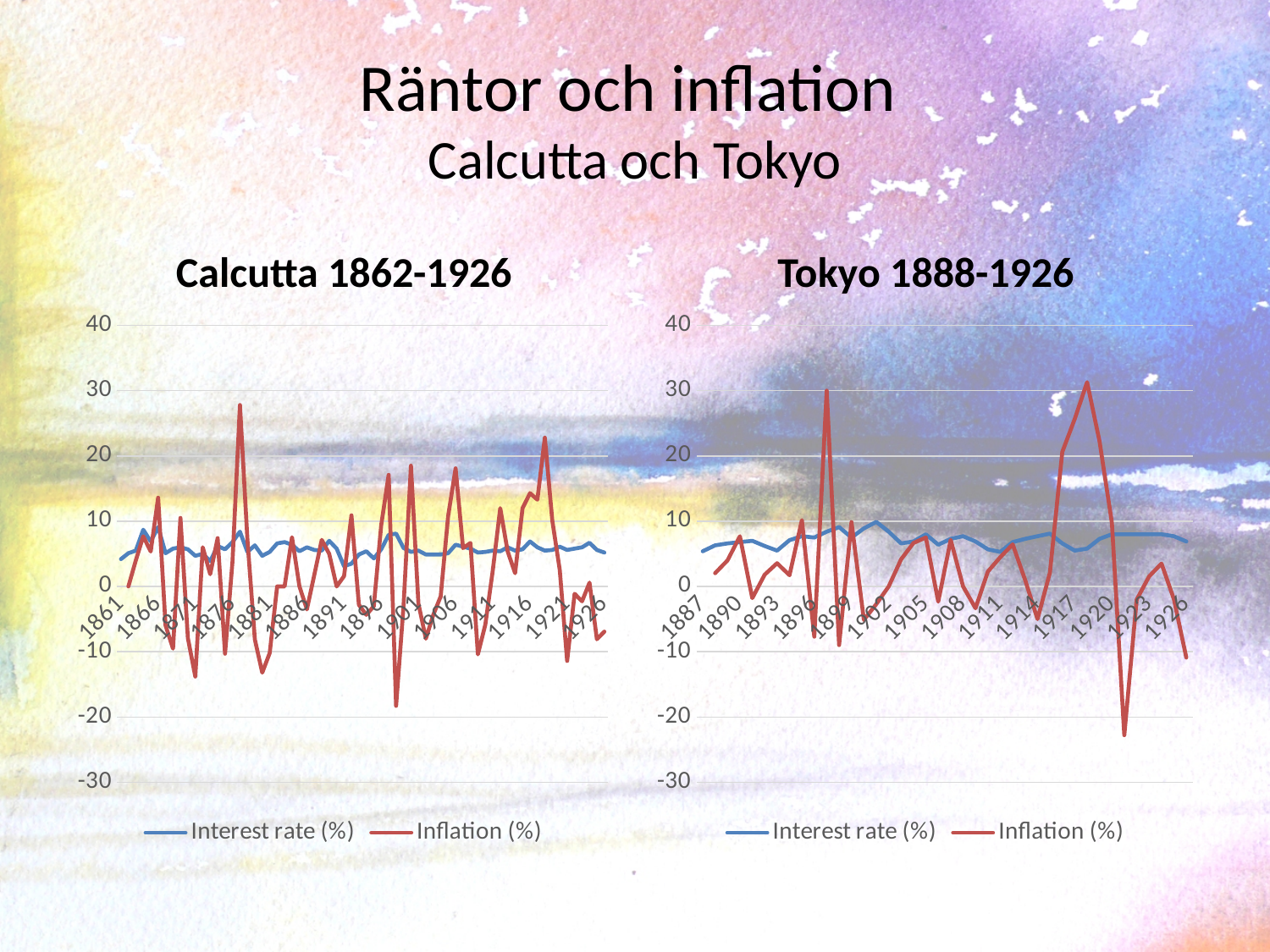
In the Calcutta 1862-1926 chart, which series reaches the lowest value, Interest rate (%) or Inflation (%)? Inflation (%) In the Tokyo 1888-1926 chart, is the lowest value of the Inflation (%) series greater or less than -10? less What kind of chart is the Calcutta 1862-1926 chart? Line chart In the Tokyo 1888-1926 chart, is the Interest rate (%) series ever less than 0? No In the Calcutta 1862-1926 chart, is the lowest value of the Inflation (%) series greater or less than -10? less In the Tokyo 1888-1926 chart, which colour is used for the Inflation (%) series? Red In the Tokyo 1888-1926 chart, which series reaches the higher maximum value, Interest rate (%) or Inflation (%)? Inflation (%) What are the two series named in the legend of the Calcutta 1862-1926 chart? Interest rate (%) and Inflation (%) How many series does the legend of the Tokyo 1888-1926 chart list? 2